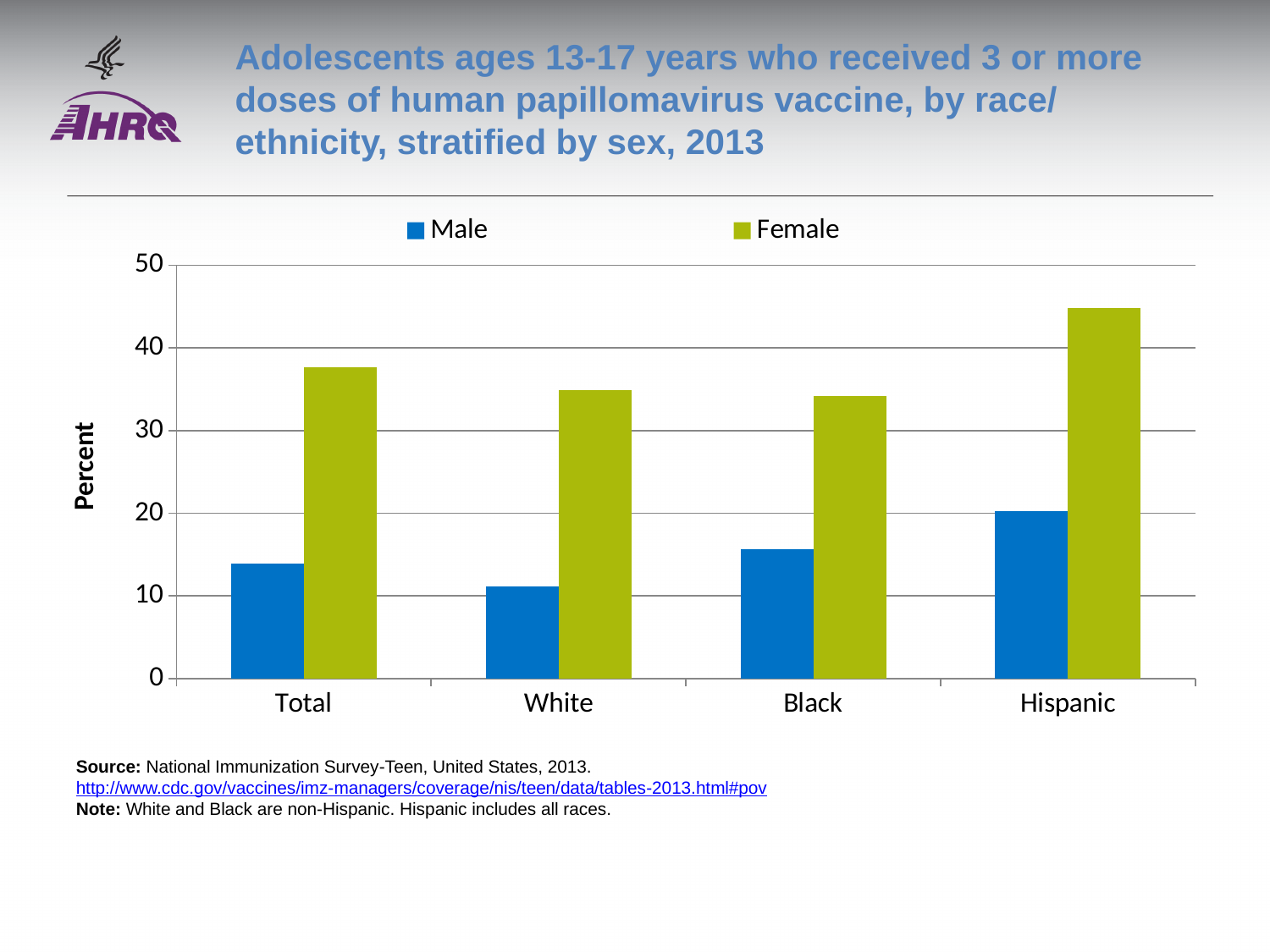
What is the label on the y axis? Percent Is the Female value for White greater or less than 30? greater Which category has the highest Male value? Hispanic What kind of chart is shown on the slide? bar chart Which category has the highest Female value? Hispanic For the Black category, which is larger, the Male value or the Female value? Female Is the Female value for Total greater or less than 40? less How many series does the legend list? 2 Is the Male value for Black greater or less than 20? less Which category has the lowest Male value? White How many race/ethnicity categories are shown on the x axis? 4